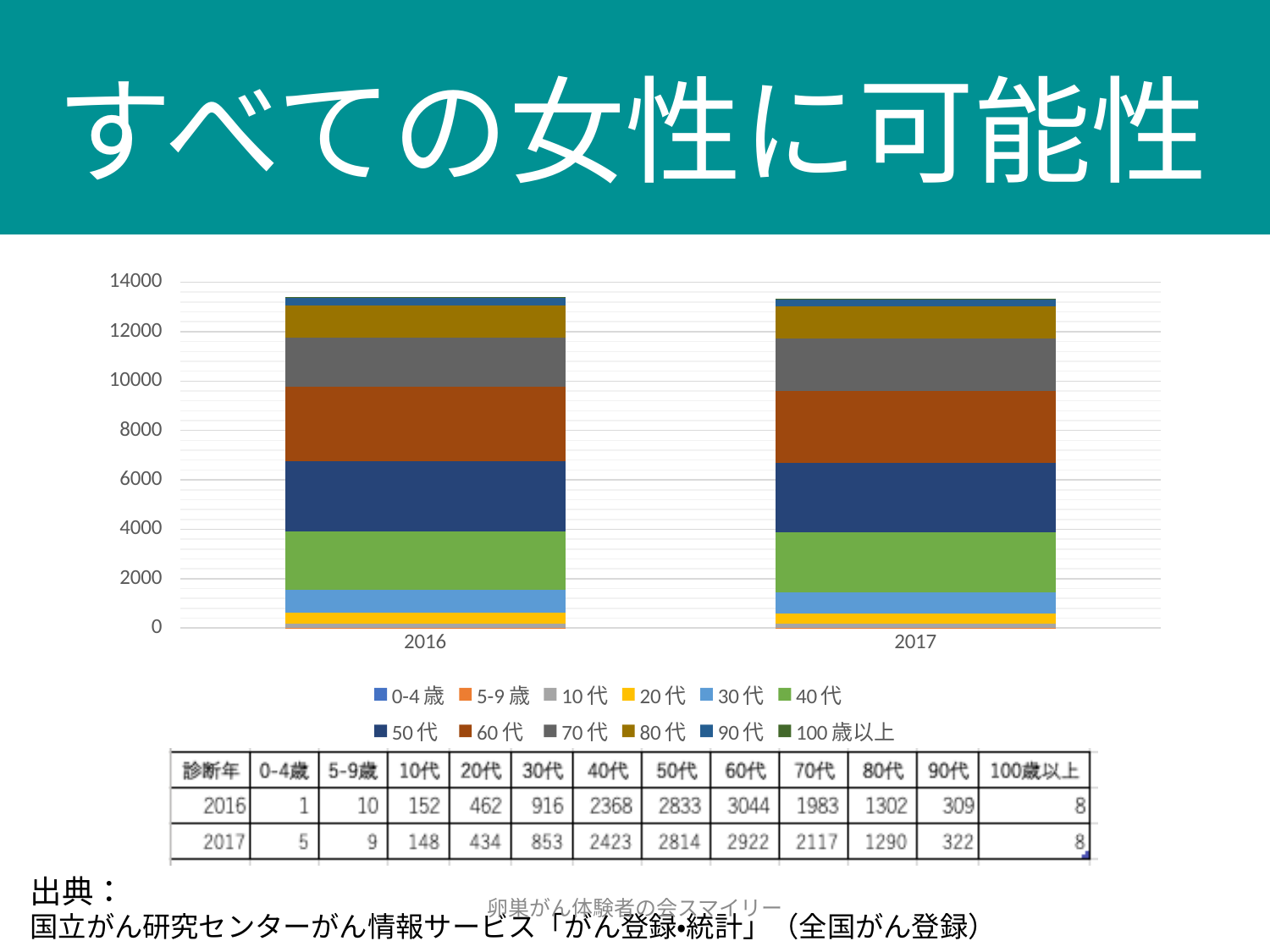
What is the total of the stacked bar for 2016? 13388 What is the value for 60代 in 2016? 3044 What is the value for 90代 in 2017? 322 What kind of chart is shown on the slide? Stacked bar chart How many years (categories) are plotted on the x axis of the chart? 2 Is the total of the stacked bar for 2017 greater or less than 12000? greater How many series does the chart's legend list? 12 What is the difference between the 70代 value in 2017 and in 2016? 134 Which age group has the highest value in 2016? 60代 Which age group has the lowest value in 2016? 0-4歳 What is the value for 40代 in 2017? 2423 Which year has the larger value for 50代, 2016 or 2017? 2016